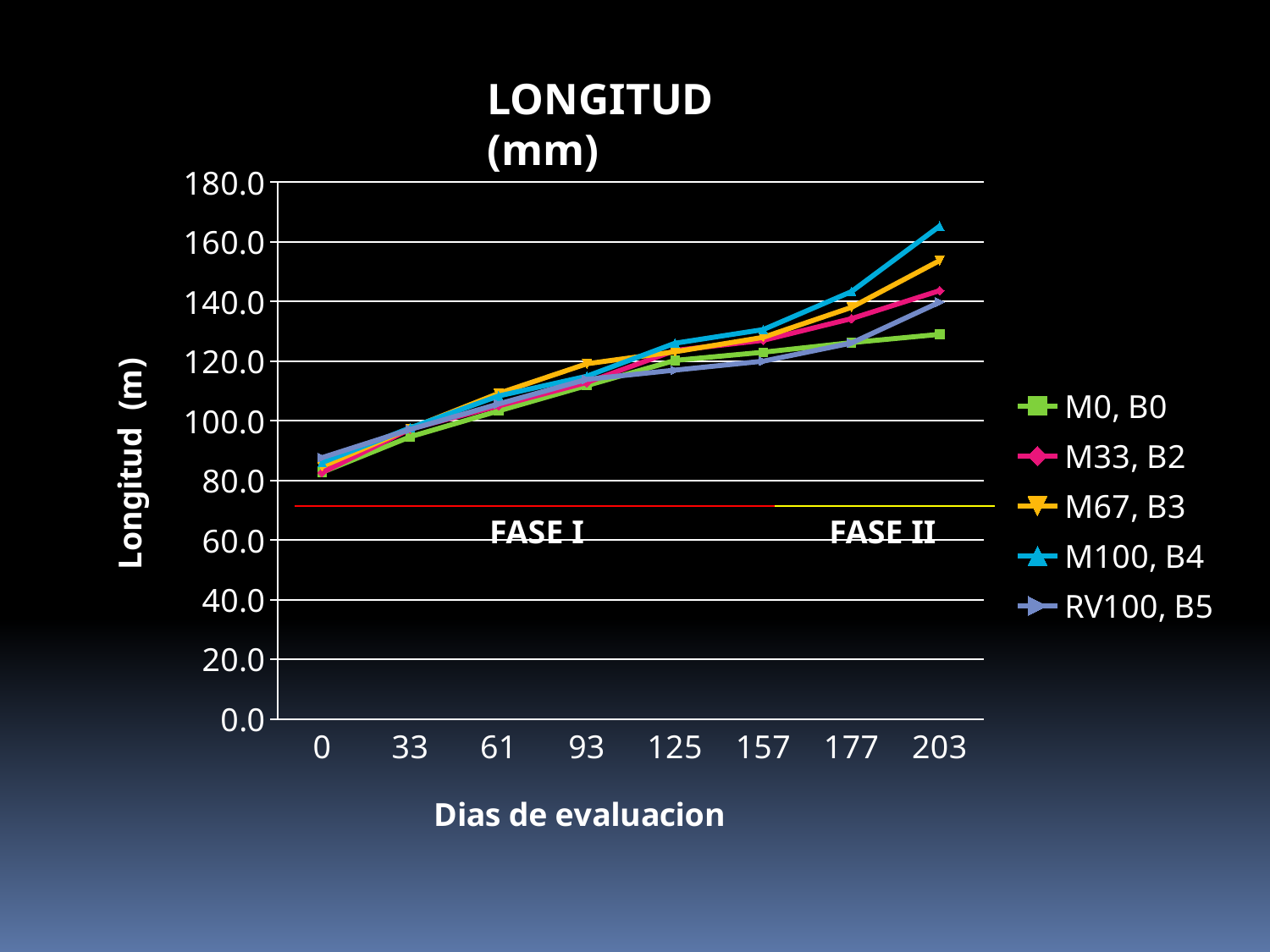
Is the value for M0, B0 at day 203 greater or less than 140? less What is the label of the x axis? Dias de evaluacion Is the value for M100, B4 at day 203 greater or less than 140? greater How many series does the legend list? 5 Is the value for M33, B2 at day 0 greater or less than 100? less What kind of chart is shown on the slide? line chart How many evaluation days (x-axis points) are plotted? 8 Which series has the lowest value at day 203? M0, B0 What is the title of the chart? LONGITUD (mm) Which series has the highest value at day 203? M100, B4 At day 203, which is larger: the value for M67, B3 or the value for M33, B2? M67, B3 Do the values for M100, B4 rise or fall as the evaluation days increase? rise